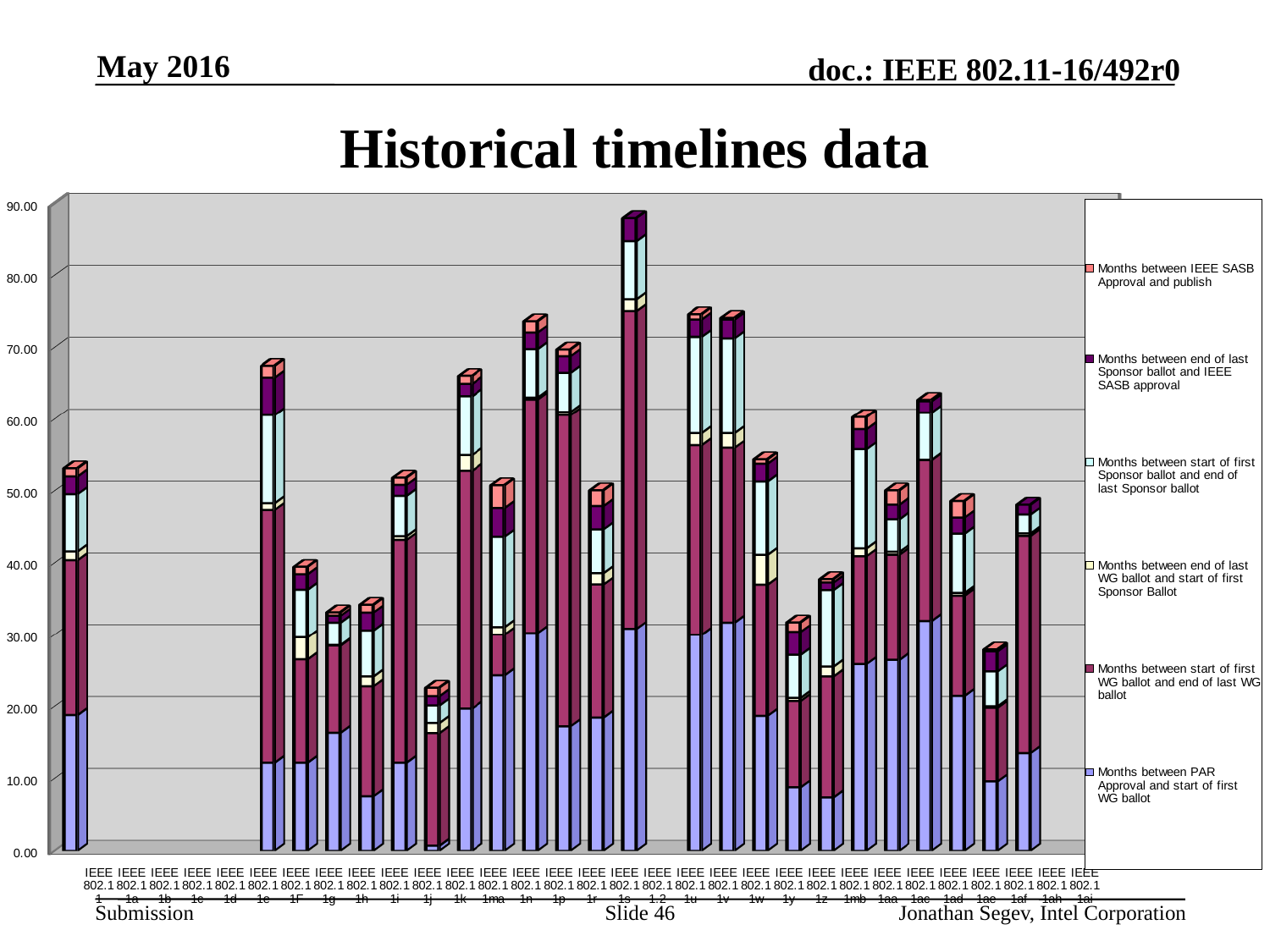
Which series forms the bottom segment of each stacked bar? Months between PAR Approval and start of first WG ballot Is the total of the shortest stacked bar greater or less than 30.00? less What is the highest value shown on the vertical axis? 90.00 What is the title of the chart? Historical timelines data What kind of chart is shown on the slide? Stacked bar chart Is the total of the tallest stacked bar greater or less than 80.00? greater How many series does the legend list? 6